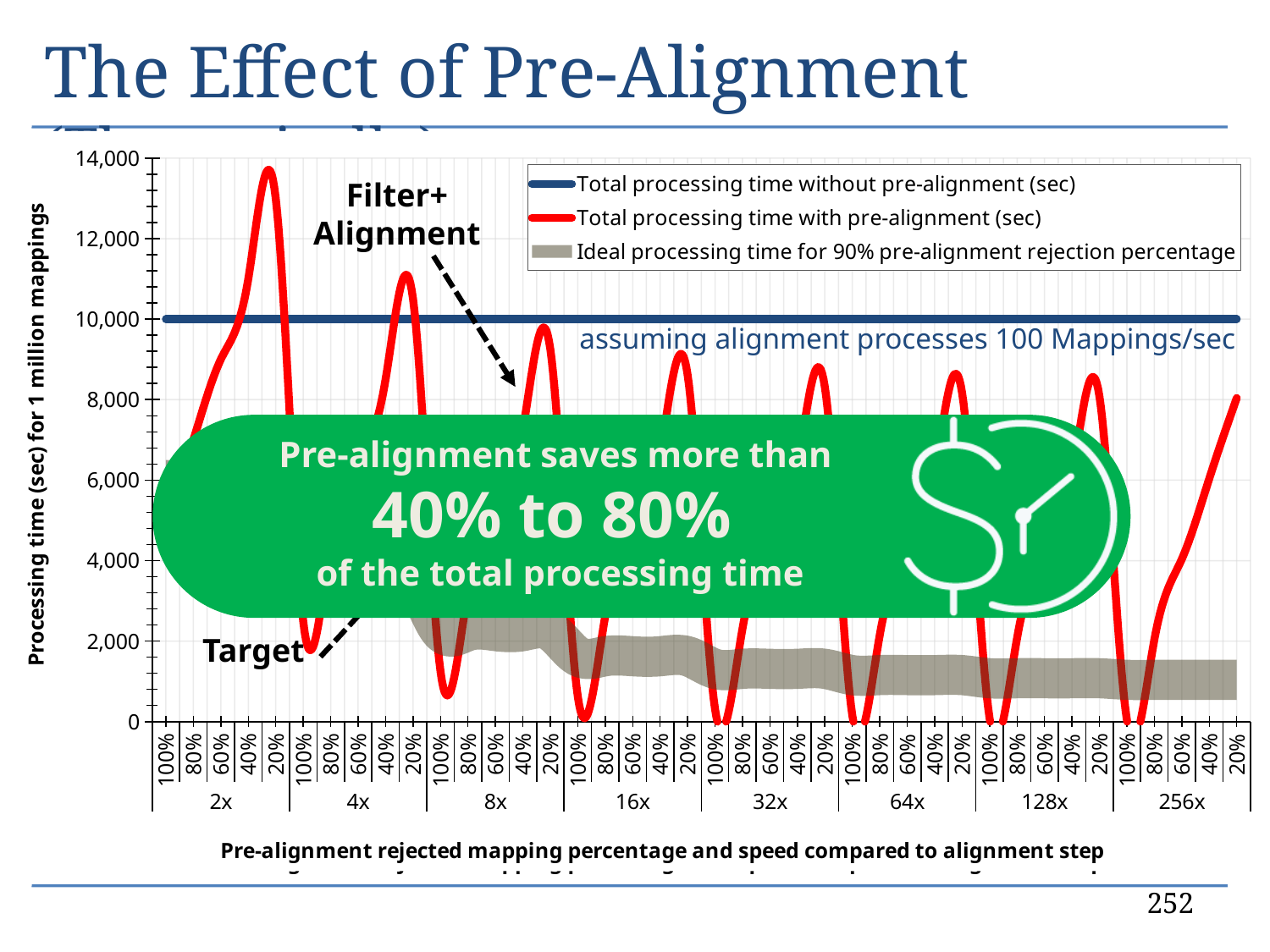
Do the peaks of the red line rise or fall as the speed increases from 2x to 256x? fall How many speed groups (2x, 4x, ...) are shown along the x axis? 8 How many series does the legend list? 3 Is the peak of the red line in the 16x group (at 20%) greater or less than 10,000? less In which speed group does the red line (total processing time with pre-alignment) reach its highest peak? 2x Is the peak of the red line in the 2x group (at 20%) greater or less than 12,000? greater What is the total processing time without pre-alignment (sec), as shown by the blue line? 10,000 Is the peak of the red line in the 4x group (at 20%) greater or less than 10,000? greater What is the title of the vertical axis? Processing time (sec) for 1 million mappings At 2x and 20%, which is larger: the total processing time with pre-alignment or without pre-alignment? with pre-alignment What kind of chart is shown on the slide? line chart At 16x and 100%, which is larger: the total processing time with pre-alignment or without pre-alignment? without pre-alignment